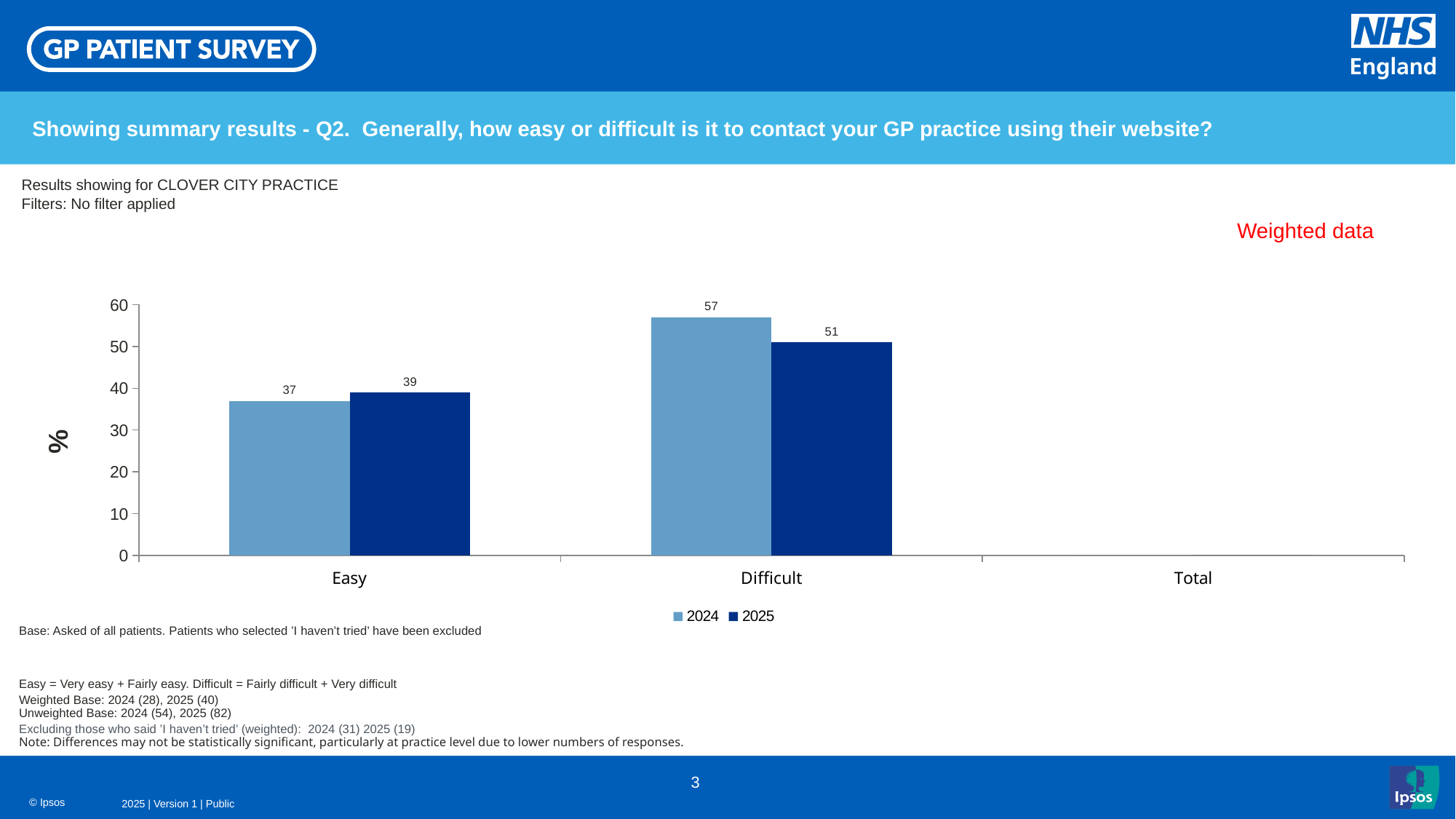
What is the value for Difficult in 2024? 57 What is the value for Easy in 2025? 39 What is the value for Easy in 2024? 37 Which is larger for Easy: the 2024 value or the 2025 value? 2025 Which category has the highest value in the 2024 series? Difficult Which category has the lowest value in the 2025 series? Easy What is the difference between the 2024 and 2025 values for Difficult? 6 What is the value for Difficult in 2025? 51 What is the label on the vertical axis? % Is the 2024 value for Difficult greater or less than 50? greater What kind of chart is shown on the slide? Bar chart How many series does the legend list? 2